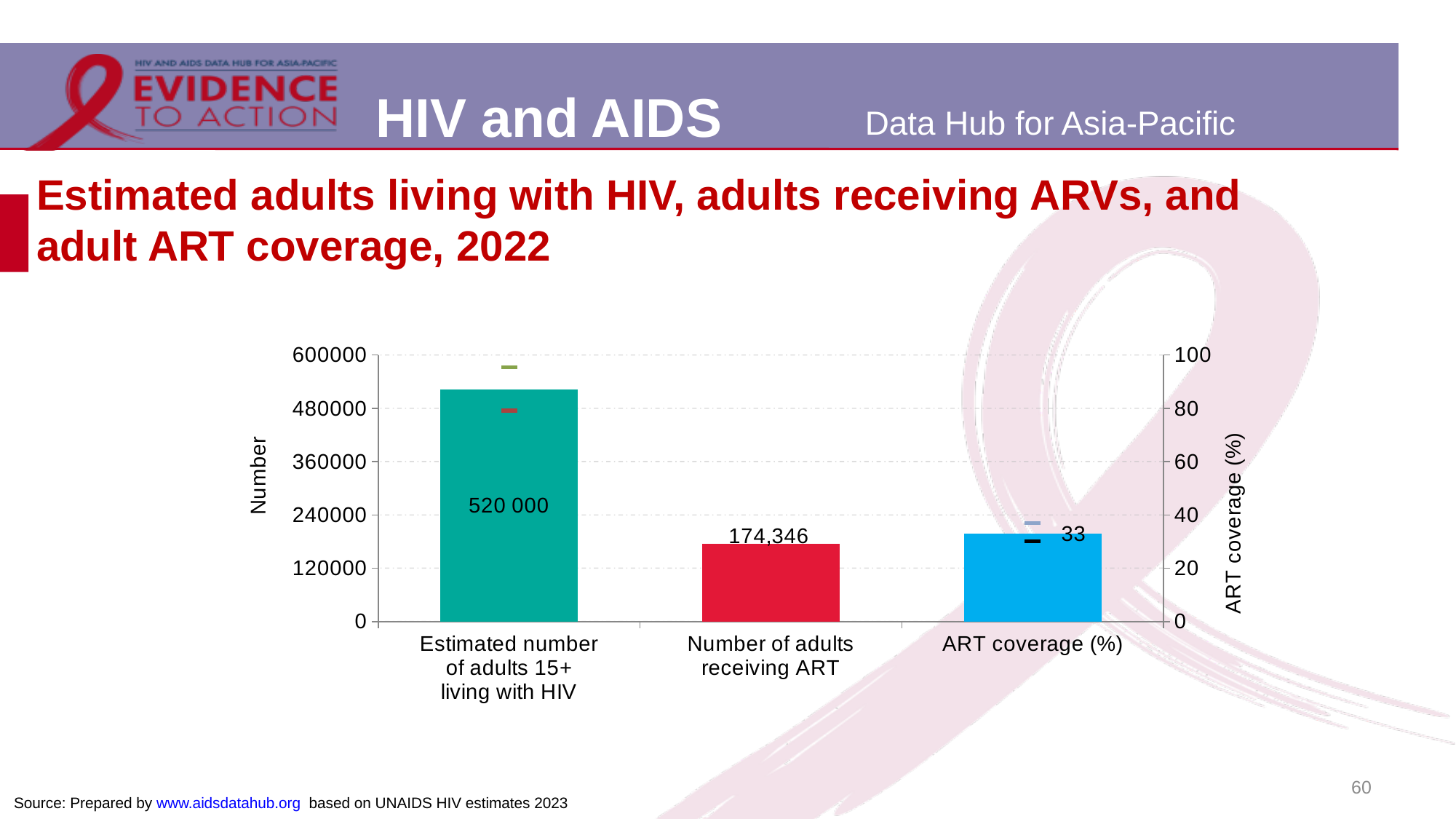
How many categories are shown on the x axis of the chart? 3 Which category has the tallest bar on the chart? Estimated number of adults 15+ living with HIV Which is larger: the estimated number of adults 15+ living with HIV or the number of adults receiving ART? Estimated number of adults 15+ living with HIV Is the number of adults receiving ART greater or less than 240000? less What is the label of the right-hand vertical axis of the chart? ART coverage (%) What is the ART coverage (%) value shown on the chart? 33 What is the estimated number of adults 15+ living with HIV shown on the chart? 520 000 What is the difference between the estimated number of adults 15+ living with HIV and the number of adults receiving ART? 345,654 Is the ART coverage (%) value greater or less than 40 on the right-hand axis? less What is the label of the left-hand vertical axis of the chart? Number What kind of chart is shown on the slide? Bar chart What is the number of adults receiving ART shown on the chart? 174,346